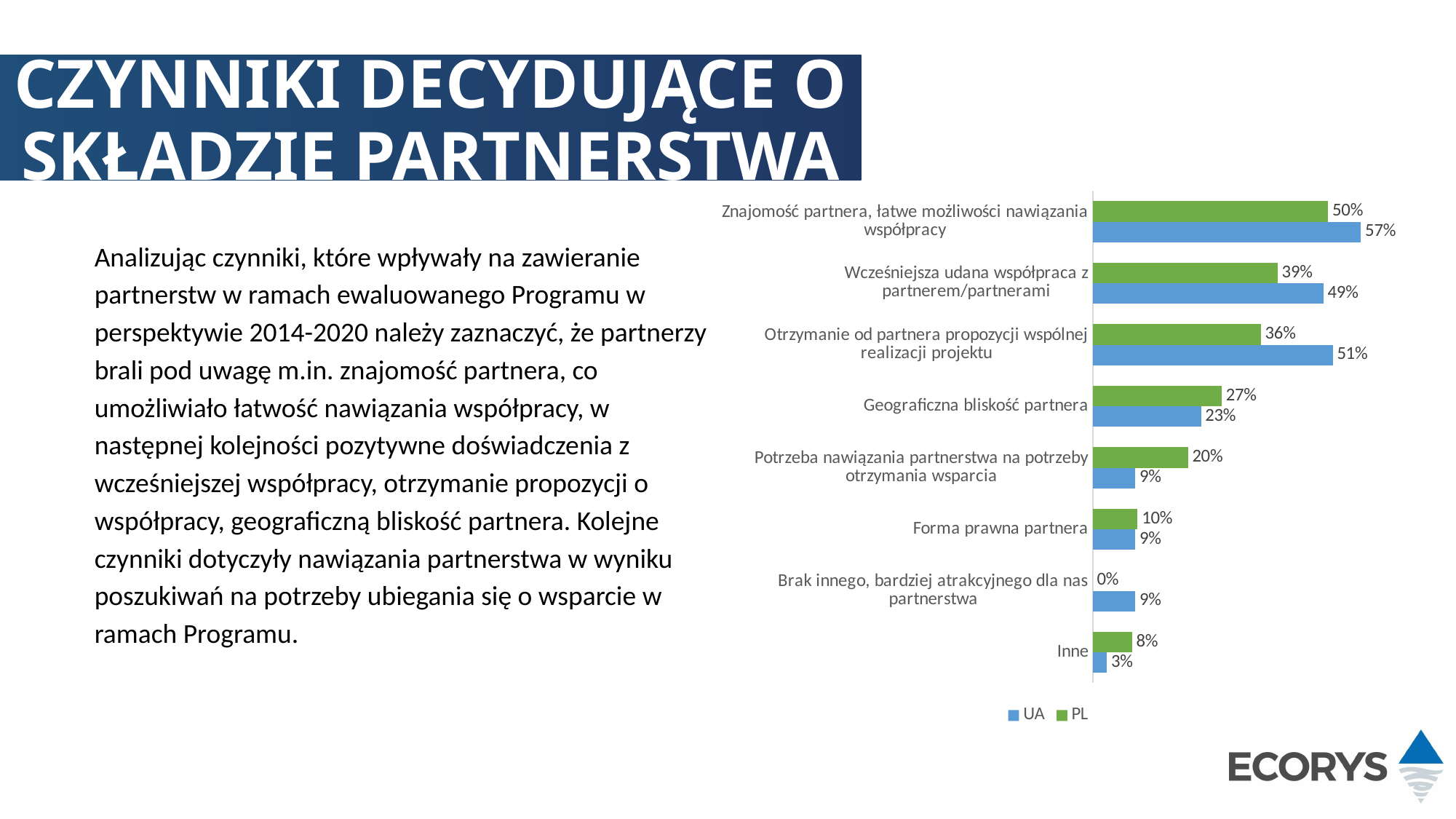
What is the difference between the UA and PL values for "Otrzymanie od partnera propozycji wspólnej realizacji projektu"? 15% How many series does the legend list? 2 How many categories are shown in the chart? 8 What is the PL value for "Geograficzna bliskość partnera"? 27% Which category has the highest UA value? Znajomość partnera, łatwe możliwości nawiązania współpracy What type of chart is shown on the slide? Bar chart What is the PL value for "Brak innego, bardziej atrakcyjnego dla nas partnerstwa"? 0% For "Wcześniejsza udana współpraca z partnerem/partnerami", which series has the larger value, UA or PL? UA Which category has the lowest PL value? Brak innego, bardziej atrakcyjnego dla nas partnerstwa For "Potrzeba nawiązania partnerstwa na potrzeby otrzymania wsparcia", which series has the larger value, UA or PL? PL What is the UA value for "Znajomość partnera, łatwe możliwości nawiązania współpracy"? 57% What is the UA value for "Inne"? 3%